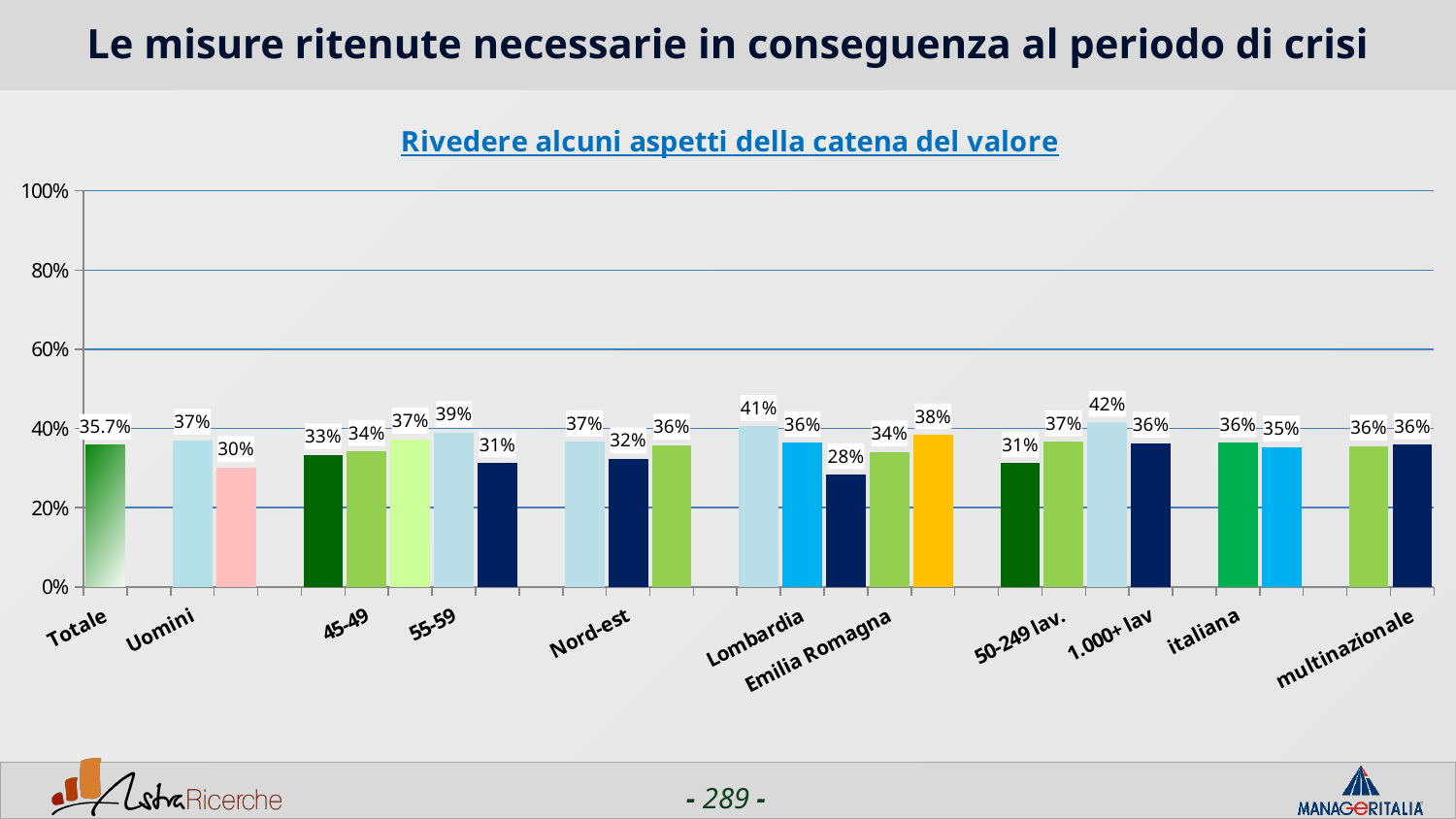
What is the value for Uomini? 37% What is the value for Totale? 35.7% Which is larger, the value for Uomini or the value for Nord-est? Uomini What kind of chart is shown on the slide? bar chart What is the highest value labelled on any bar in the chart? 42% Is the value for Totale greater or less than 40%? less What is the subtitle shown above the chart? Rivedere alcuni aspetti della catena del valore What is the lowest value labelled on any bar in the chart? 28% What is the value for 55-59? 39% What is the value for 50-249 lav.? 37% What is the value for Nord-est? 32% What is the value for Emilia Romagna? 34%